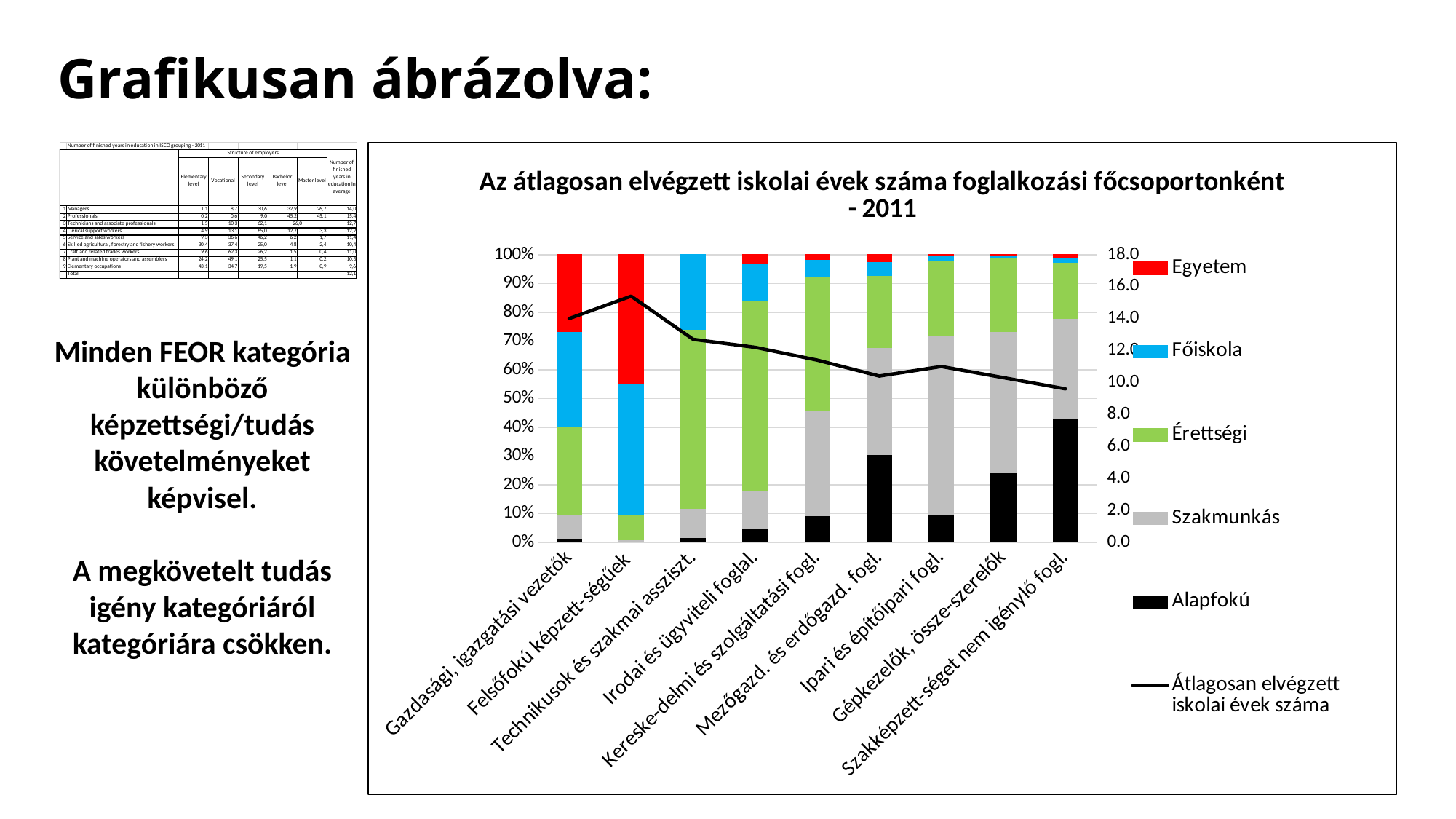
Which category has the largest Alapfokú (black) share? Szakképzett-séget nem igénylő fogl. How many occupation categories are shown on the x axis of the chart? 9 Does the Átlagosan elvégzett iskolai évek száma line generally rise or fall from left to right across the categories? Fall How many series does the chart legend list? 6 Is the Egyetem share for Felsőfokú képzett-ségűek greater or less than 40%? greater What kind of chart is shown on the slide? Stacked bar chart with a line Is the Átlagosan elvégzett iskolai évek száma value for Gazdasági, igazgatási vezetők greater or less than 12.0? greater What is the title of the chart? Az átlagosan elvégzett iskolai évek száma foglalkozási főcsoportonként - 2011 Which category has the largest Egyetem (red) share? Felsőfokú képzett-ségűek Which colour represents the Alapfokú series in the chart? Black Which has a larger Szakmunkás (grey) share: Gépkezelők, össze-szerelők or Gazdasági, igazgatási vezetők? Gépkezelők, össze-szerelők Is the Alapfokú share for Szakképzett-séget nem igénylő fogl. greater or less than 30%? greater